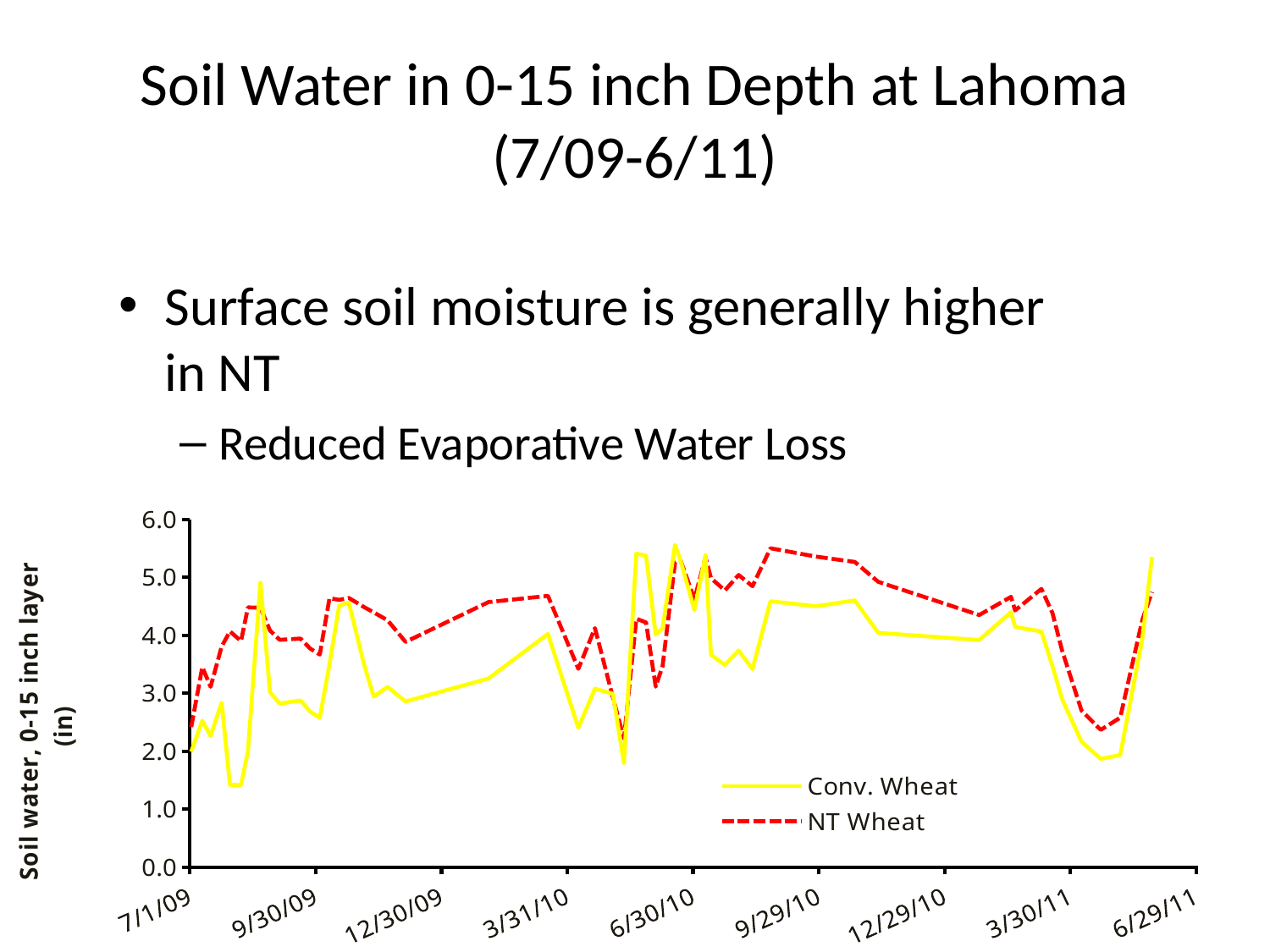
How many date labels are shown along the x axis? 9 At 12/30/09, which series has the higher value, Conv. Wheat or NT Wheat? NT Wheat Is the lowest value for Conv. Wheat greater or less than 2.0? less What is the label on the vertical axis? Soil water, 0-15 inch layer (in) At 9/29/10, which series has the higher value, Conv. Wheat or NT Wheat? NT Wheat Which series is drawn with a red dashed line? NT Wheat How many series does the legend list? 2 Is the value for Conv. Wheat at 12/30/09 greater or less than 4.0? less What kind of chart is shown on the slide? line chart Does the NT Wheat line rise or fall between 9/29/10 and 12/29/10? fall Is the value for NT Wheat at 9/29/10 greater or less than 5.0? greater